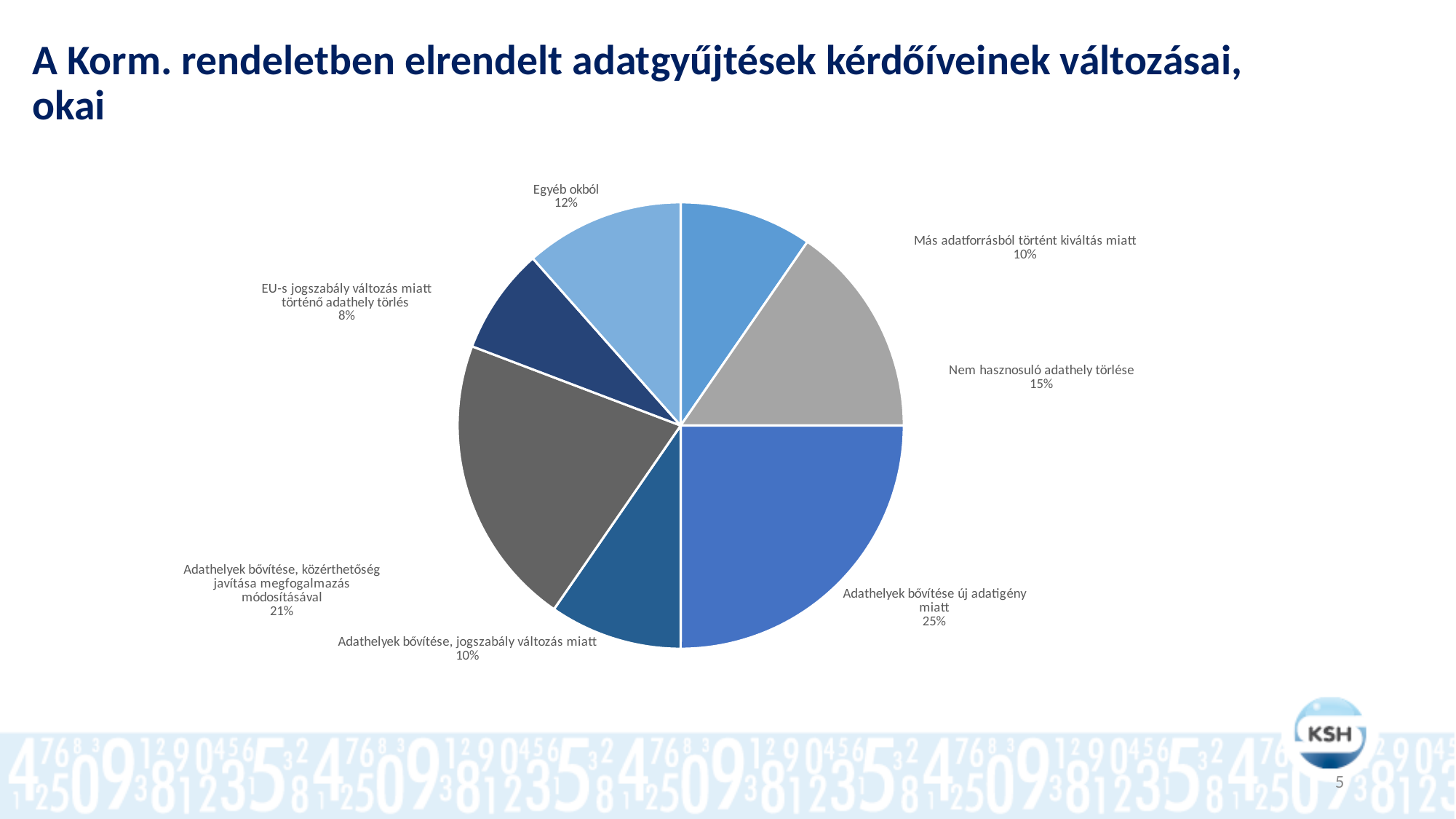
What is the title of the slide containing the pie chart? A Korm. rendeletben elrendelt adatgyűjtések kérdőíveinek változásai, okai Which category has the smallest share of the pie? EU-s jogszabály változás miatt történő adathely törlés What percentage is shown for "Nem hasznosuló adathely törlése"? 15% Which is larger: the share for "Nem hasznosuló adathely törlése" or the share for "Egyéb okból"? Nem hasznosuló adathely törlése What percentage is shown for "Egyéb okból"? 12% What percentage is shown for "EU-s jogszabály változás miatt történő adathely törlés"? 8% What is the difference in percentage points between "Adathelyek bővítése új adatigény miatt" and "Adathelyek bővítése, közérthetőség javítása megfogalmazás módosításával"? 4 What kind of chart is shown on the slide? pie chart Which category has the largest share of the pie? Adathelyek bővítése új adatigény miatt What percentage is shown for "Más adatforrásból történt kiváltás miatt"? 10% What share of the pie is labelled "Adathelyek bővítése új adatigény miatt"? 25% How many slices does the pie chart have? 7